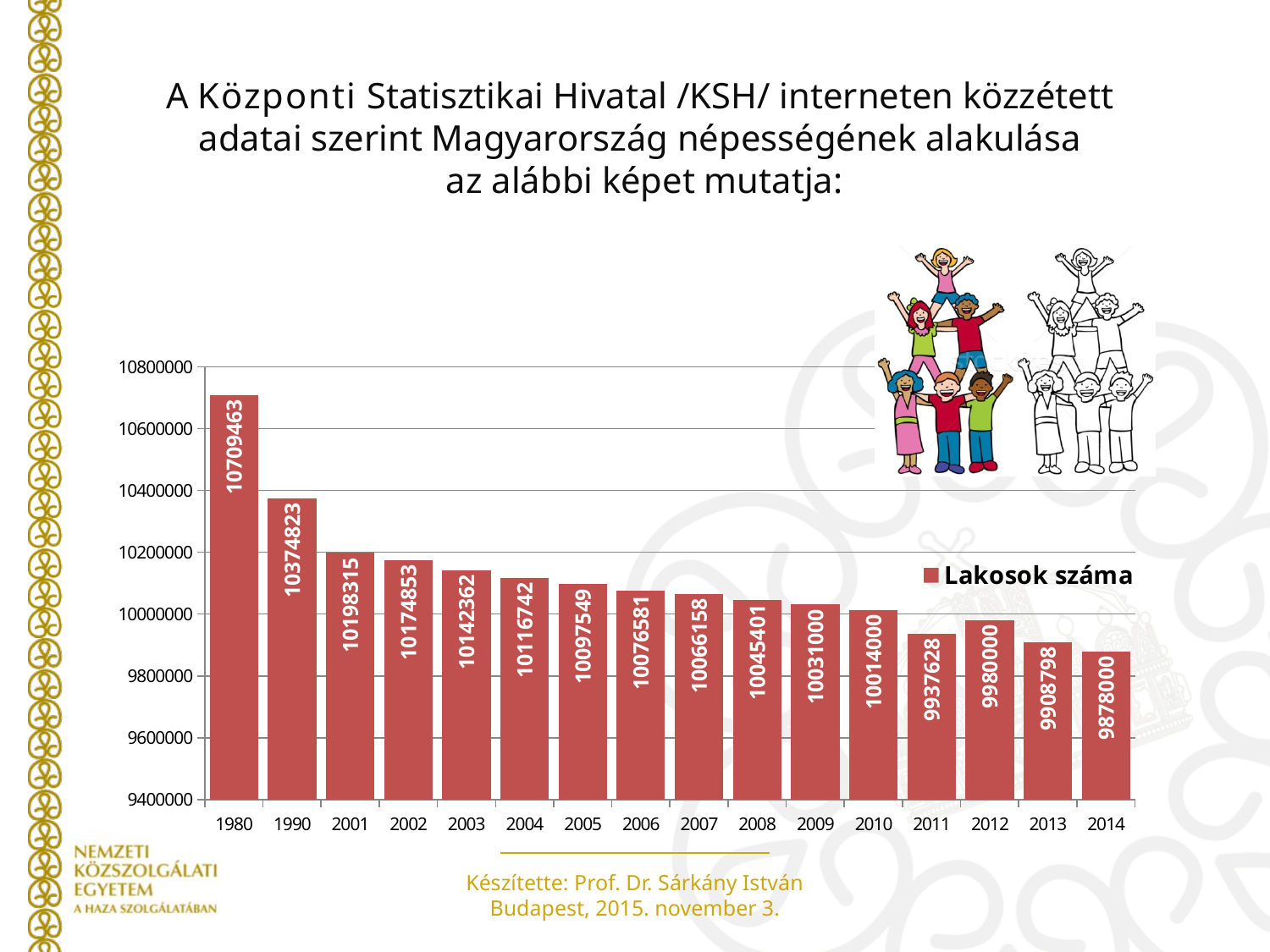
What is the difference between the values for 1980 and 2014? 831463 Is the value for 2013 greater or less than 10000000? less Which is larger, the value for 2011 or the value for 2012? 2012 What kind of chart is shown on the slide? bar chart Which year has the lowest value in the chart? 2014 How many years are shown on the x axis of the chart? 16 Which year has the highest value in the chart? 1980 What is the value for 2014 in the chart? 9878000 What is the value for 2005 in the chart? 10097549 What is the difference between the values for 2012 and 2011? 42372 What is the name of the series listed in the chart legend? Lakosok száma What is the value for 1980 in the chart? 10709463